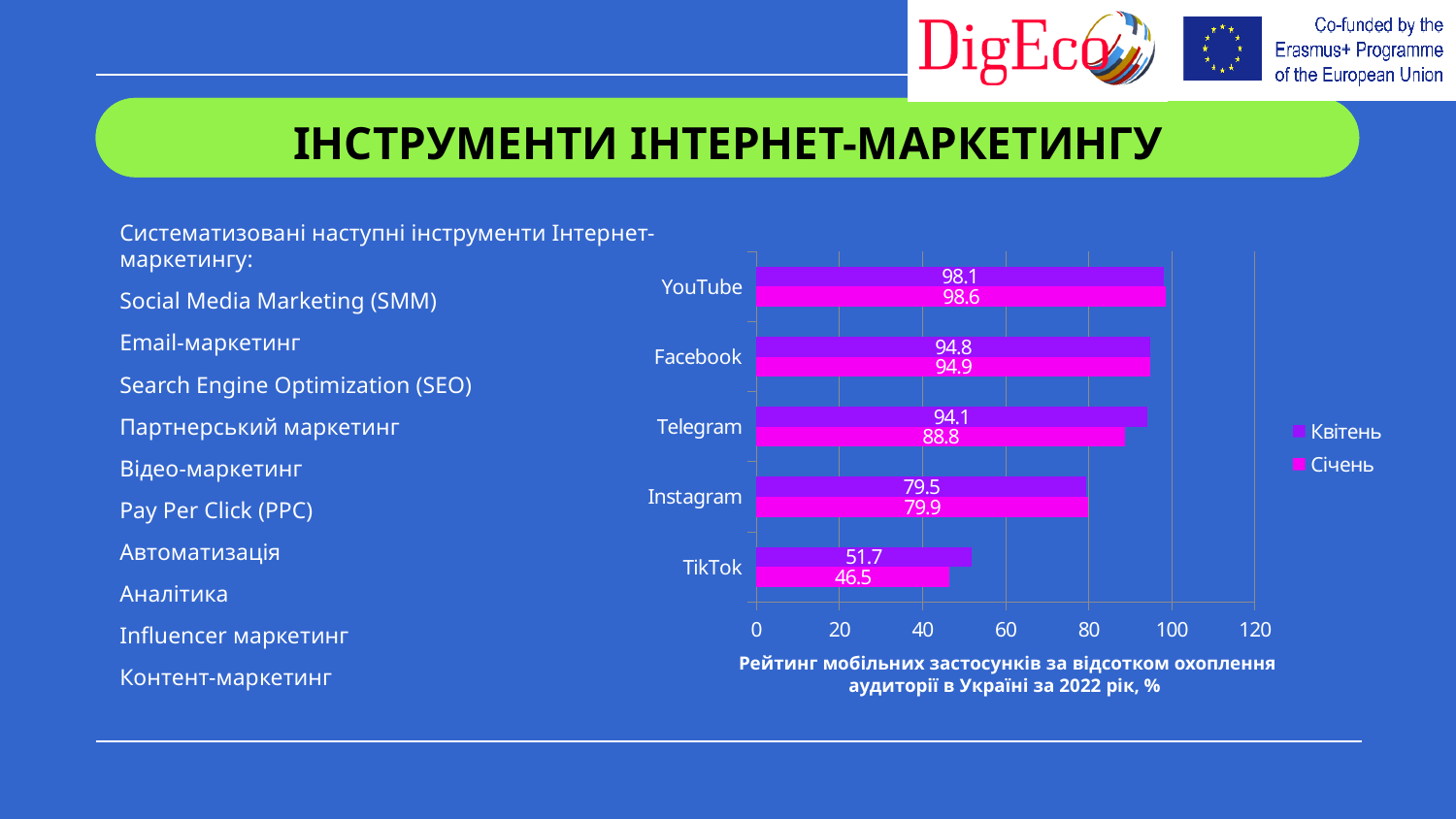
Is the Квітень value for Instagram greater or less than 80? less How many series does the legend list? 2 Which app has the highest value in the Січень series? YouTube What is the difference between the Квітень and Січень values for TikTok? 5.2 What is the value for TikTok in the Січень series? 46.5 Which is larger for Instagram: the Квітень value or the Січень value? Січень What type of chart is shown on the slide? bar chart What is the difference between the Квітень and Січень values for Telegram? 5.3 How many apps are shown on the chart? 5 Which app has the lowest value in the Квітень series? TikTok What is the value for YouTube in the Квітень series? 98.1 What is the value for Telegram in the Січень series? 88.8